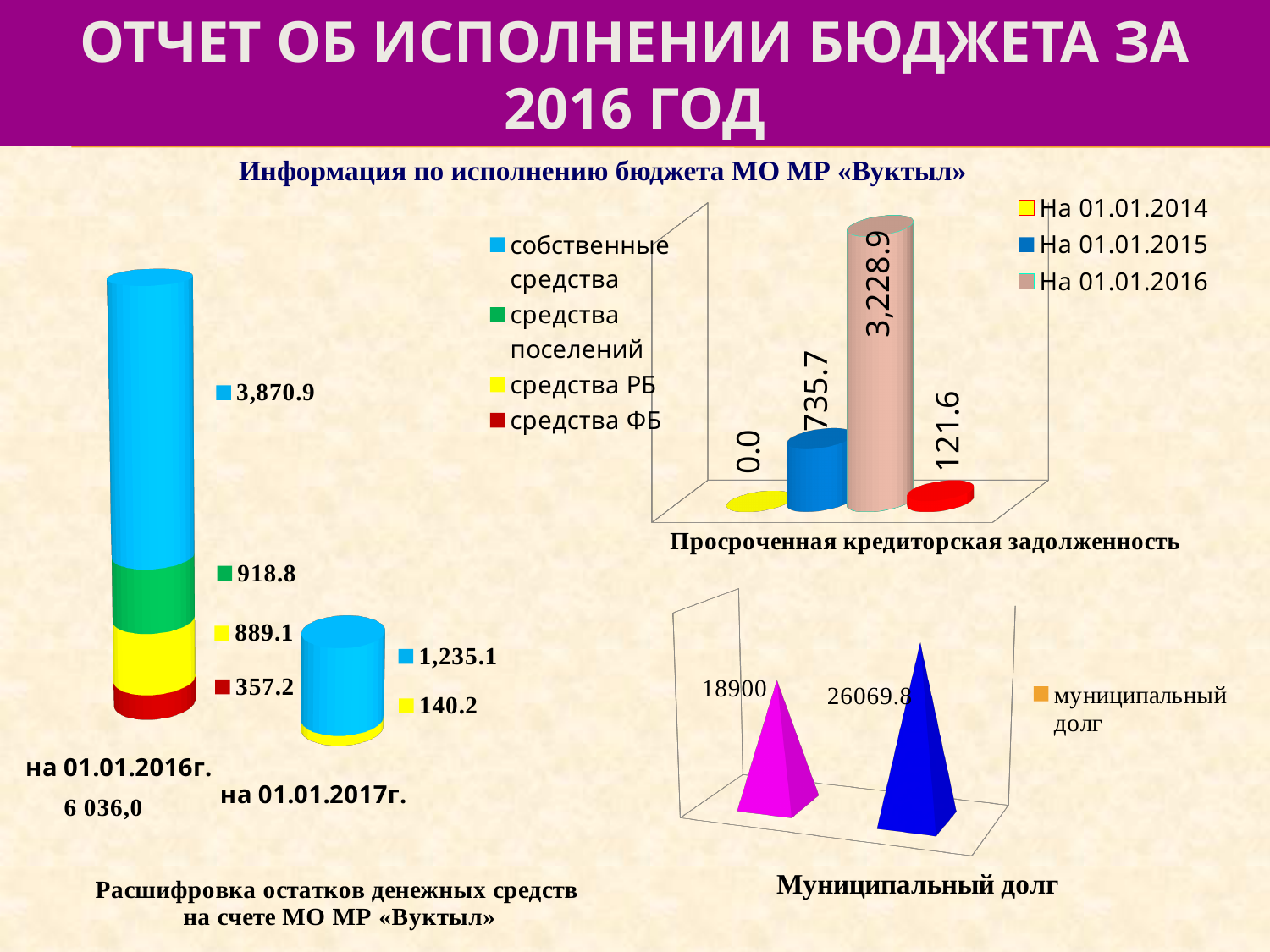
In the chart 'Расшифровка остатков денежных средств на счете МО МР «Вуктыл»', which is larger for на 01.01.2016г.: средства поселений or средства РБ? средства поселений In the chart 'Муниципальный долг', what is the value of the first (left) data point? 18900 In the chart 'Просроченная кредиторская задолженность', which legend date has the highest value? На 01.01.2016 In the chart 'Расшифровка остатков денежных средств на счете МО МР «Вуктыл»', what is the value of средства ФБ for на 01.01.2016г.? 357.2 In the chart 'Расшифровка остатков денежных средств на счете МО МР «Вуктыл»', what is the value of средства РБ for на 01.01.2017г.? 140.2 In the chart 'Просроченная кредиторская задолженность', what is the value for На 01.01.2016? 3,228.9 In the chart 'Муниципальный долг', what is the difference between the two plotted values? 7169.8 In the chart 'Расшифровка остатков денежных средств на счете МО МР «Вуктыл»', what is the value of собственные средства for на 01.01.2016г.? 3,870.9 In the chart 'Расшифровка остатков денежных средств на счете МО МР «Вуктыл»', how many series does the legend list? 4 In the chart 'Просроченная кредиторская задолженность', what is the value for На 01.01.2015? 735.7 In the chart 'Расшифровка остатков денежных средств на счете МО МР «Вуктыл»', what is the difference between собственные средства на 01.01.2016г. and на 01.01.2017г.? 2,635.8 In the chart 'Расшифровка остатков денежных средств на счете МО МР «Вуктыл»', what is the total shown for the bar на 01.01.2016г.? 6 036,0